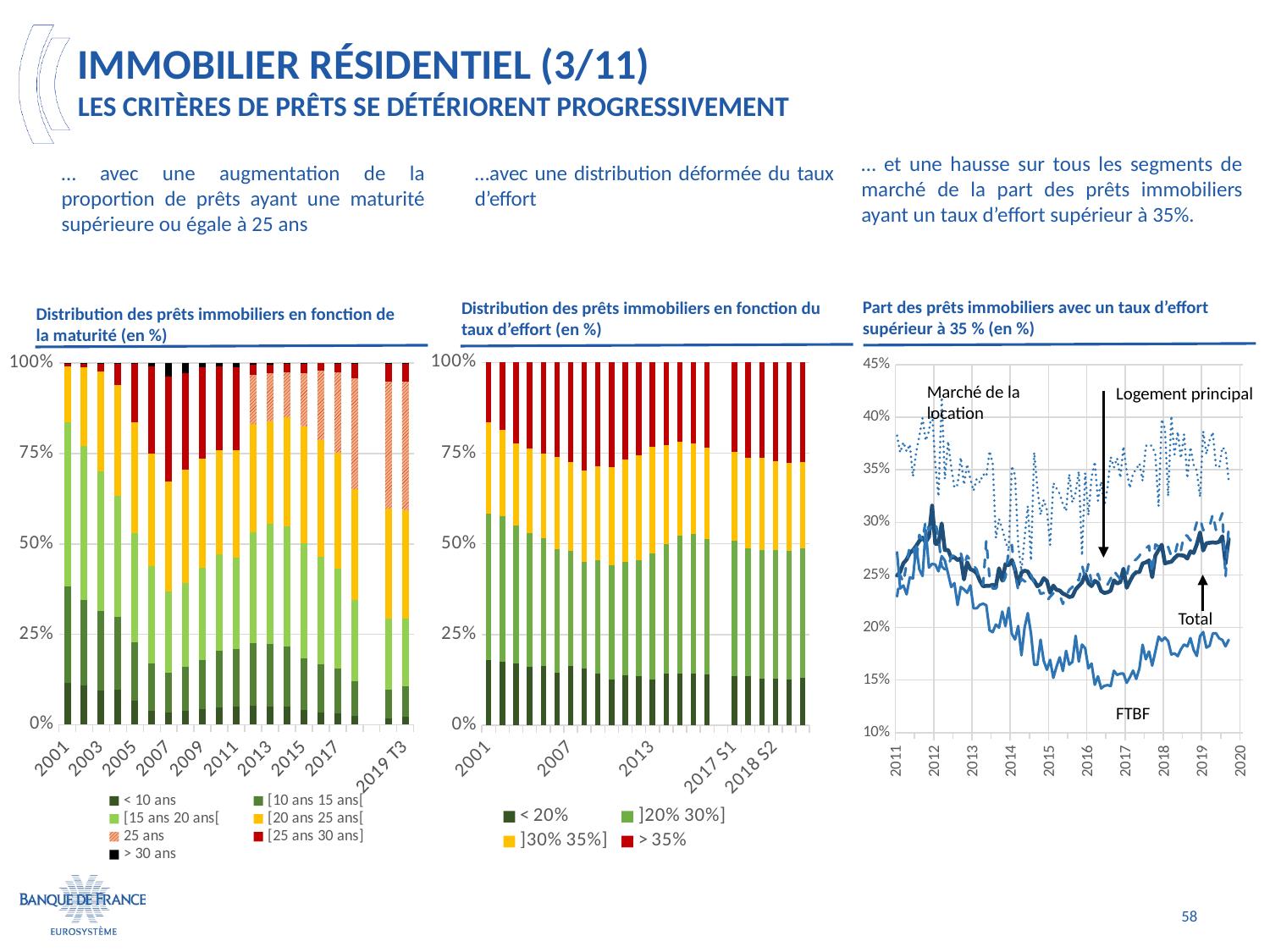
In the right chart (taux d'effort supérieur à 35 %), which series is higher in 2016: 'Marché de la location' or 'FTBF'? Marché de la location What are the four legend entries of the middle chart (distribution by taux d'effort)? < 20%, ]20% 30%], ]30% 35%], > 35% In the right chart (taux d'effort supérieur à 35 %), does the FTBF line rise or fall from 2011 to 2016? fall In the right chart (taux d'effort supérieur à 35 %), is the 'Marché de la location' value in 2018 greater or less than 30%? greater How many series does the legend of the left chart (distribution by maturité) list? 7 What kind of chart is the left chart, 'Distribution des prêts immobiliers en fonction de la maturité (en %)'? Stacked bar chart How many series does the legend of the middle chart (distribution by taux d'effort) list? 4 In the middle chart (distribution by taux d'effort), does the '< 20%' share rise or fall from 2001 to 2018 S2? fall In the middle chart (distribution by taux d'effort), is the '< 20%' share in 2001 greater or less than 50%? less What kind of chart is the right chart, 'Part des prêts immobiliers avec un taux d'effort supérieur à 35 % (en %)'? Line chart In the middle chart (distribution by taux d'effort), is the '< 20%' share in 2018 S2 greater or less than 25%? less